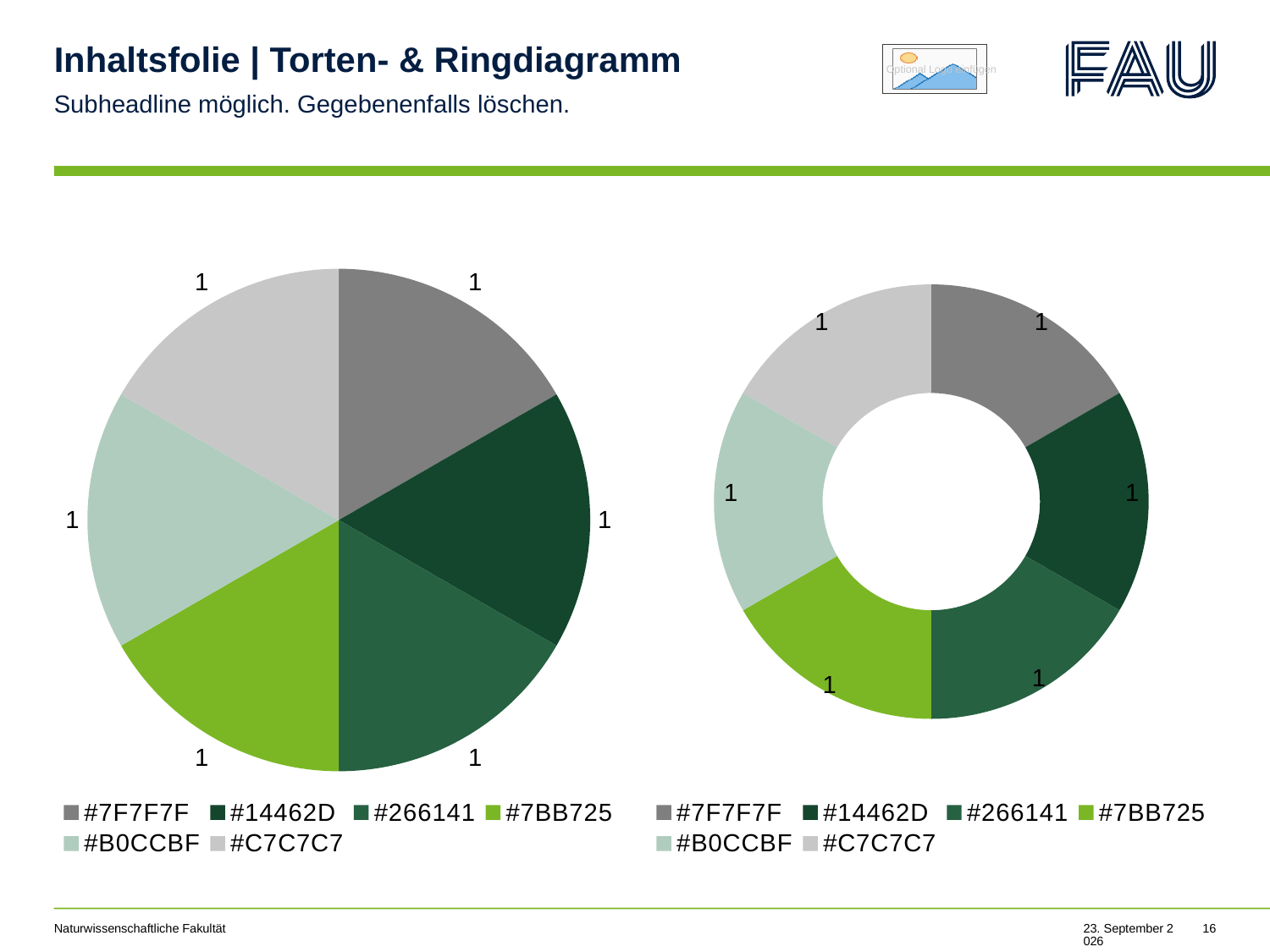
How many entries does the legend of the pie chart on the left list? 6 In the pie chart on the left, is the value for #14462D larger than, smaller than, or equal to the value for #266141? equal What kind of chart is the chart on the left of the slide? pie chart In the pie chart on the left, what is the value of the #7F7F7F slice? 1 What is the first entry listed in the legend of the doughnut chart on the right? #7F7F7F In the doughnut chart on the right, what is the value of the #7BB725 segment? 1 In the pie chart on the left, what is the value of the #C7C7C7 slice? 1 In the pie chart on the left, what fraction of the whole does the #B0CCBF slice represent? 1/6 In the doughnut chart on the right, how many segments are there? 6 In the pie chart on the left, how many slices are there? 6 What kind of chart is the chart on the right of the slide? doughnut chart In the doughnut chart on the right, what is the total of all segment values? 6